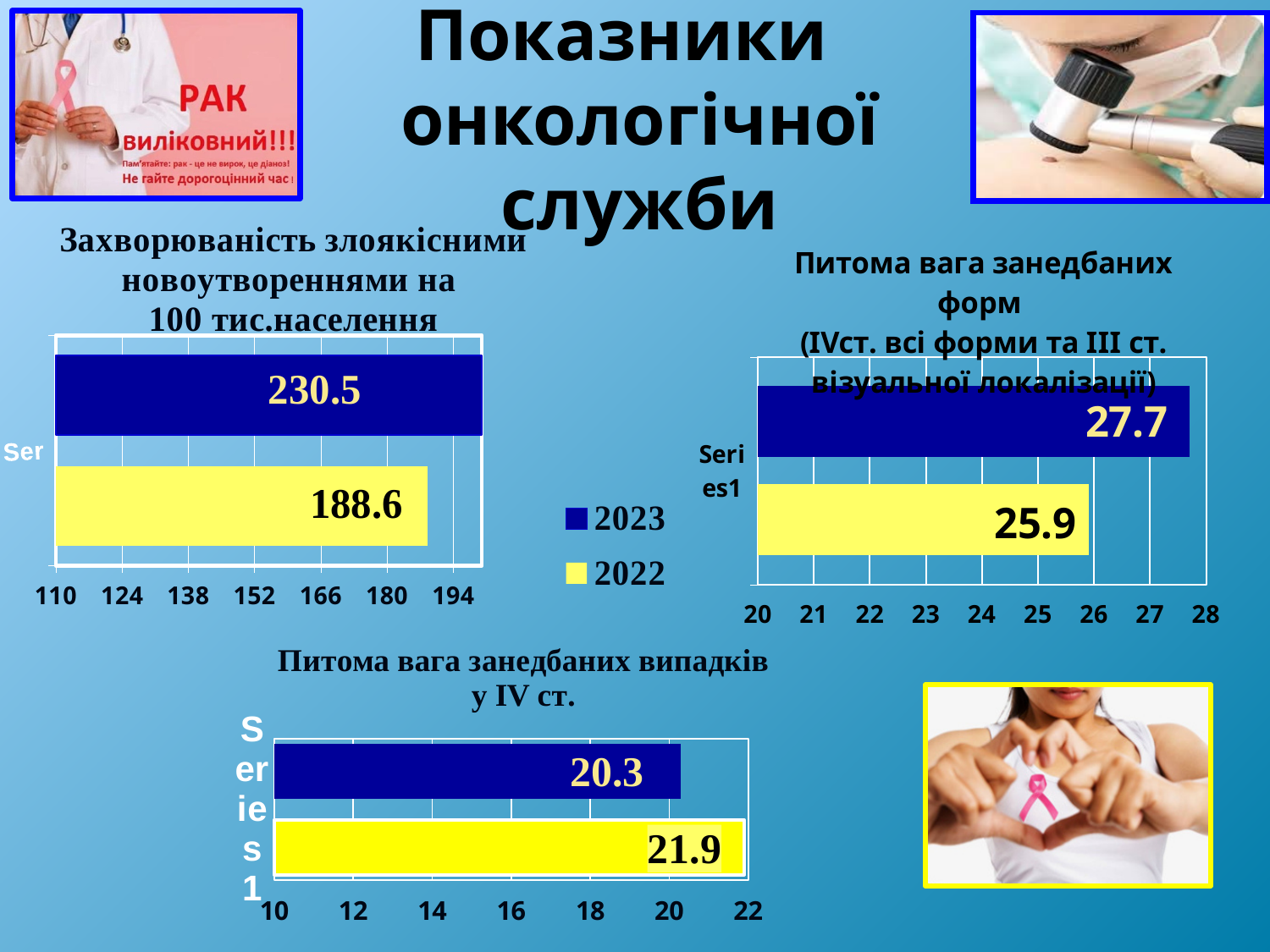
In the chart titled "Питома вага занедбаних форм" (top right), what is the value for 2023 (dark blue bar)? 27.7 In the chart titled "Питома вага занедбаних випадків у IV ст." (bottom), what is the value for 2023 (dark blue bar)? 20.3 How many entries does the legend in the middle of the slide list? 2 In the chart titled "Питома вага занедбаних випадків у IV ст." (bottom), which year has the lower value? 2023 In the chart titled "Захворюваність злоякісними новоутвореннями на 100 тис.населення", what is the value for 2023 (dark blue bar)? 230.5 In the chart titled "Питома вага занедбаних випадків у IV ст." (bottom), what is the difference between the 2022 and 2023 values? 1.6 In the chart titled "Питома вага занедбаних випадків у IV ст." (bottom), what is the value for 2022 (yellow bar)? 21.9 What kind of chart is the chart titled "Захворюваність злоякісними новоутвореннями на 100 тис.населення"? Bar chart In the chart titled "Питома вага занедбаних форм" (top right), what is the value for 2022 (yellow bar)? 25.9 In the chart titled "Захворюваність злоякісними новоутвореннями на 100 тис.населення", what is the difference between the 2023 and 2022 values? 41.9 In the chart titled "Питома вага занедбаних форм" (top right), which year has the higher value, 2023 or 2022? 2023 In the chart titled "Захворюваність злоякісними новоутвореннями на 100 тис.населення", what is the value for 2022 (yellow bar)? 188.6